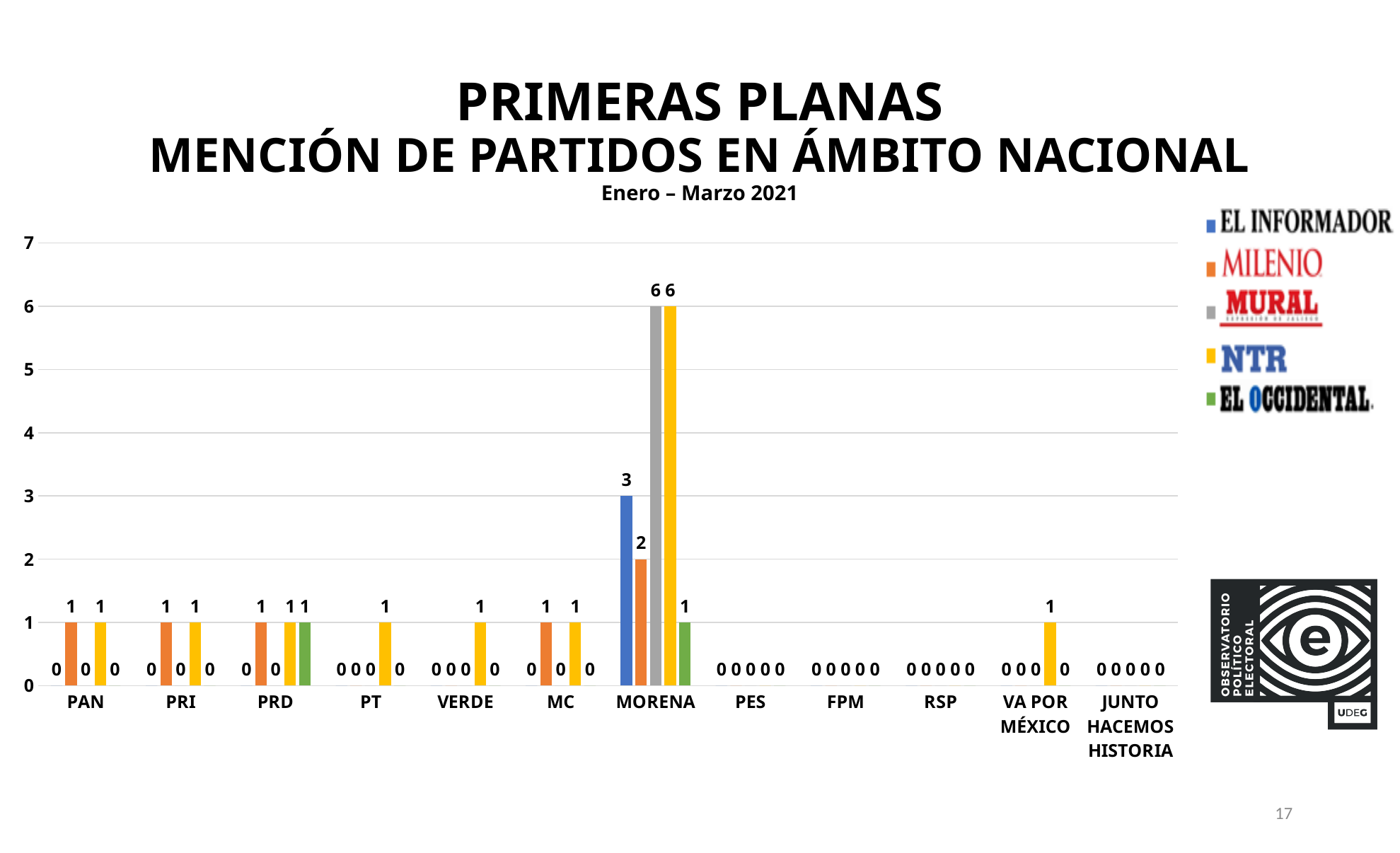
How many series does the legend list? 5 What period does the chart subtitle cover? Enero – Marzo 2021 What is the total of all five series for MORENA? 18 What is the difference between the Mural value and the Milenio value for MORENA? 4 What is the value for MORENA in the El Informador series? 3 What is the value for MORENA in the Milenio series? 2 How many party categories are shown on the x axis? 12 Which is larger for MORENA: the El Informador value or the El Occidental value? El Informador What is the value for PRD in the El Occidental series? 1 Which party has the highest value in the NTR series? MORENA What kind of chart is shown on the slide? bar chart What is the value for MORENA in the Mural series? 6